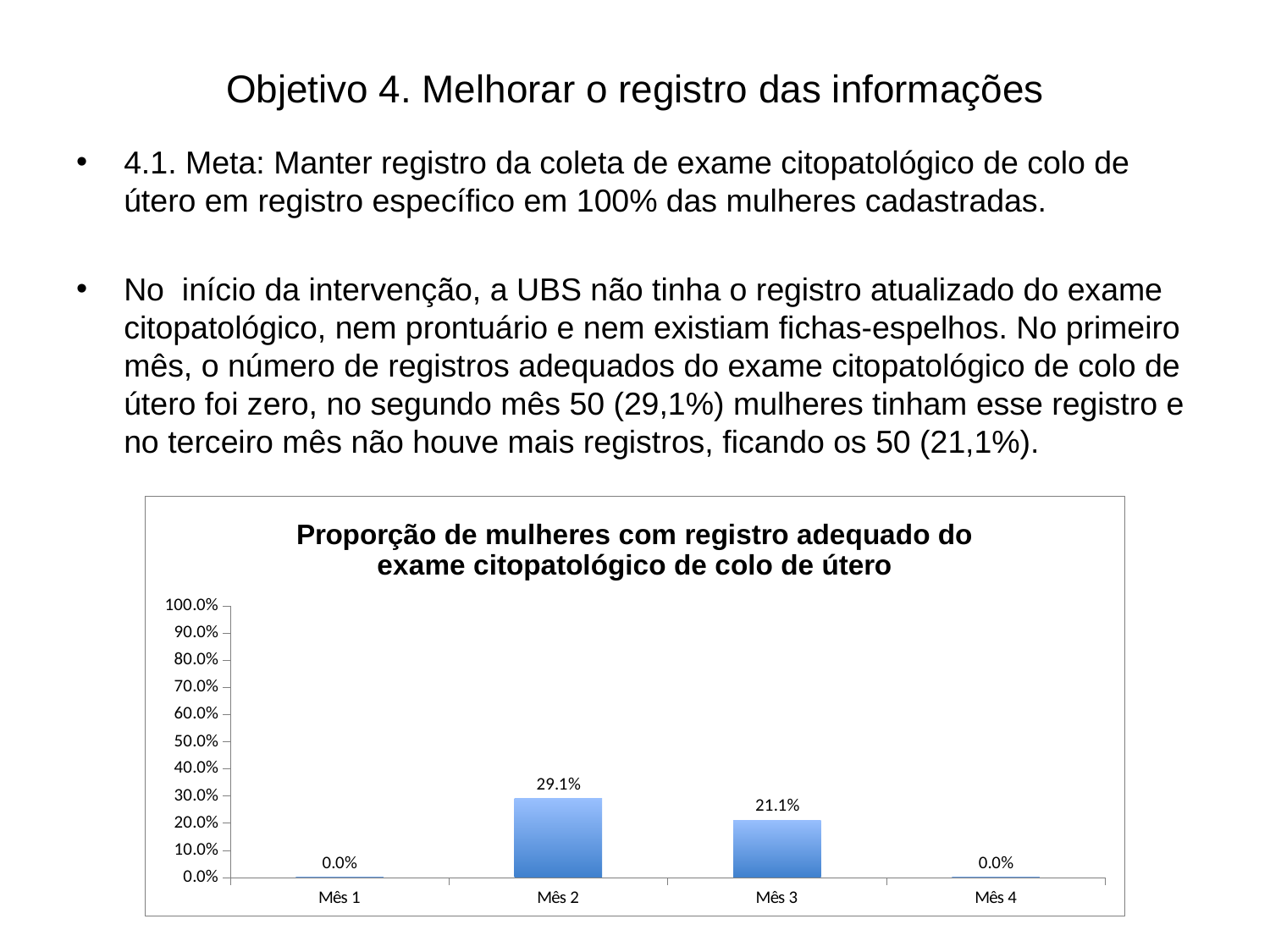
How many months are shown on the x axis? 4 Which is larger, the value for Mês 2 or the value for Mês 3? Mês 2 What is the value for Mês 3? 21.1% What kind of chart is shown on the slide? bar chart What is the value for Mês 1? 0.0% Is the value for Mês 2 greater or less than 20.0%? greater Is the value for Mês 3 greater or less than 30.0%? less What is the value for Mês 2? 29.1% Which month has the highest value? Mês 2 What is the title of the chart? Proporção de mulheres com registro adequado do exame citopatológico de colo de útero What is the difference between the values for Mês 2 and Mês 3? 8.0% What is the value for Mês 4? 0.0%